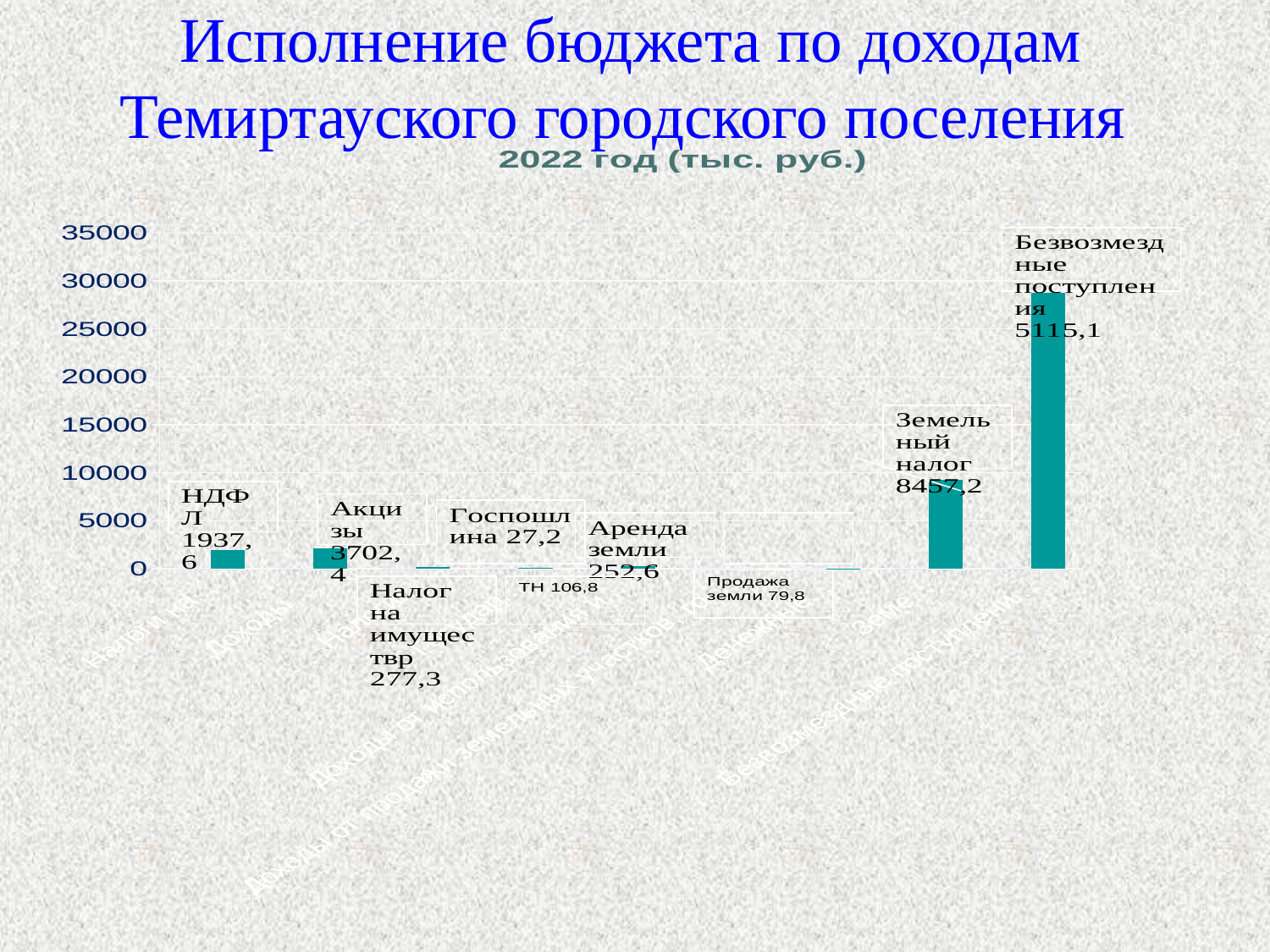
What kind of chart is shown on the slide? bar chart Which category has the smallest value? Госпошлина Which is larger, Акцизы or НДФЛ? Акцизы What is the value for Земельный налог? 8457,2 What is the difference between Земельный налог and Акцизы? 4754,8 What is the title of the chart? 2022 год (тыс. руб.) Which category has the tallest bar? Безвозмездные поступления What is the value for Госпошлина? 27,2 What is the value for Акцизы? 3702,4 What is the value for НДФЛ? 1937,6 What is the value for Продажа земли? 79,8 Is the value for Безвозмездные поступления greater or less than 25000? greater